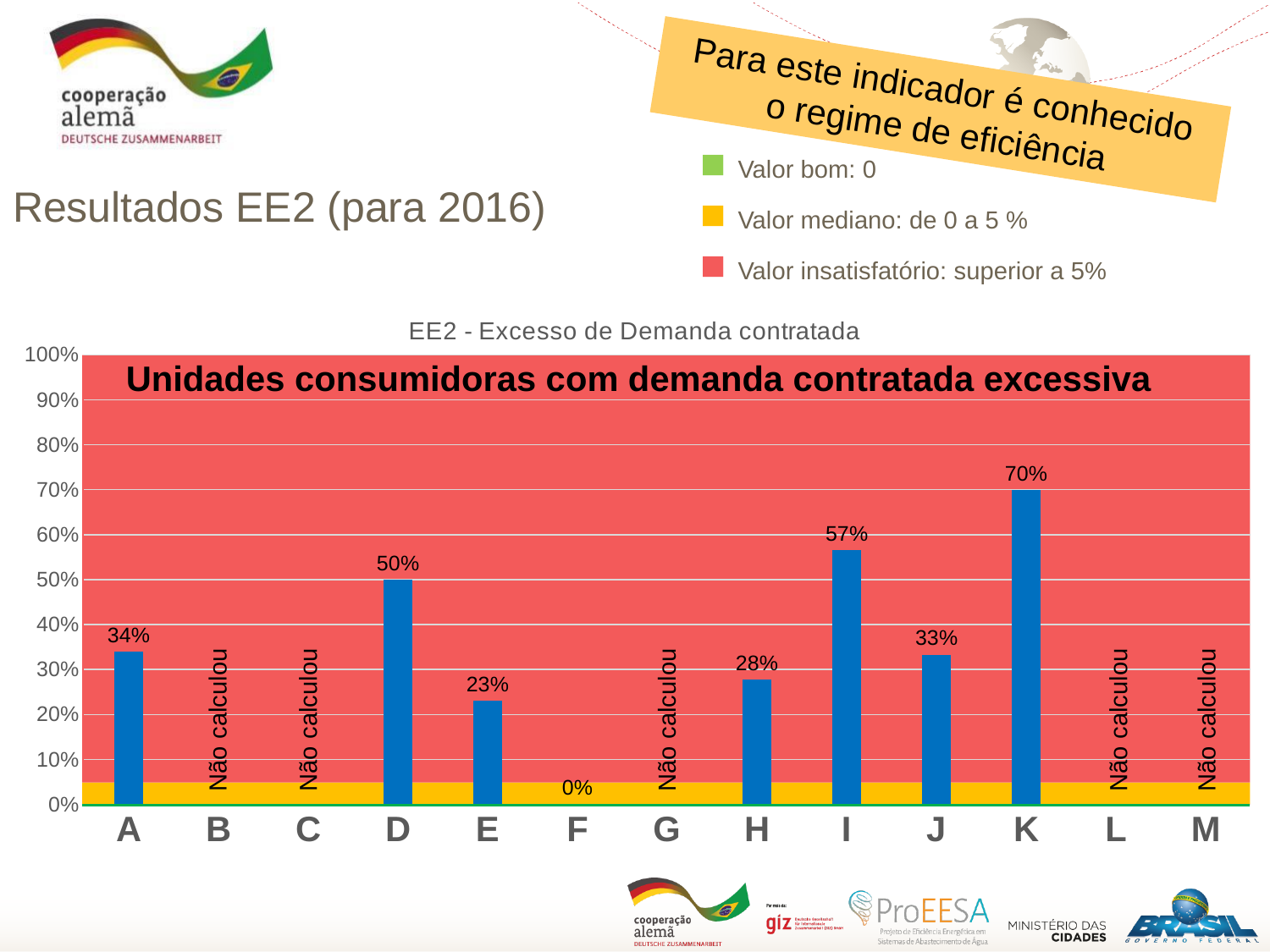
What label is shown for categories B, C, G, L and M instead of a bar? Não calculou Which is larger, the value for A or the value for H? A What is the value for category E? 23% What is the title of the chart? EE2 - Excesso de Demanda contratada How many categories are shown on the x axis? 13 What kind of chart is this? Bar chart What is the difference between the values for K and I? 13% Which category has the highest value? K What is the value for category D? 50% Is the value for I greater or less than 50%? greater Among the categories with a plotted value, which has the lowest value? F What is the value for category K? 70%